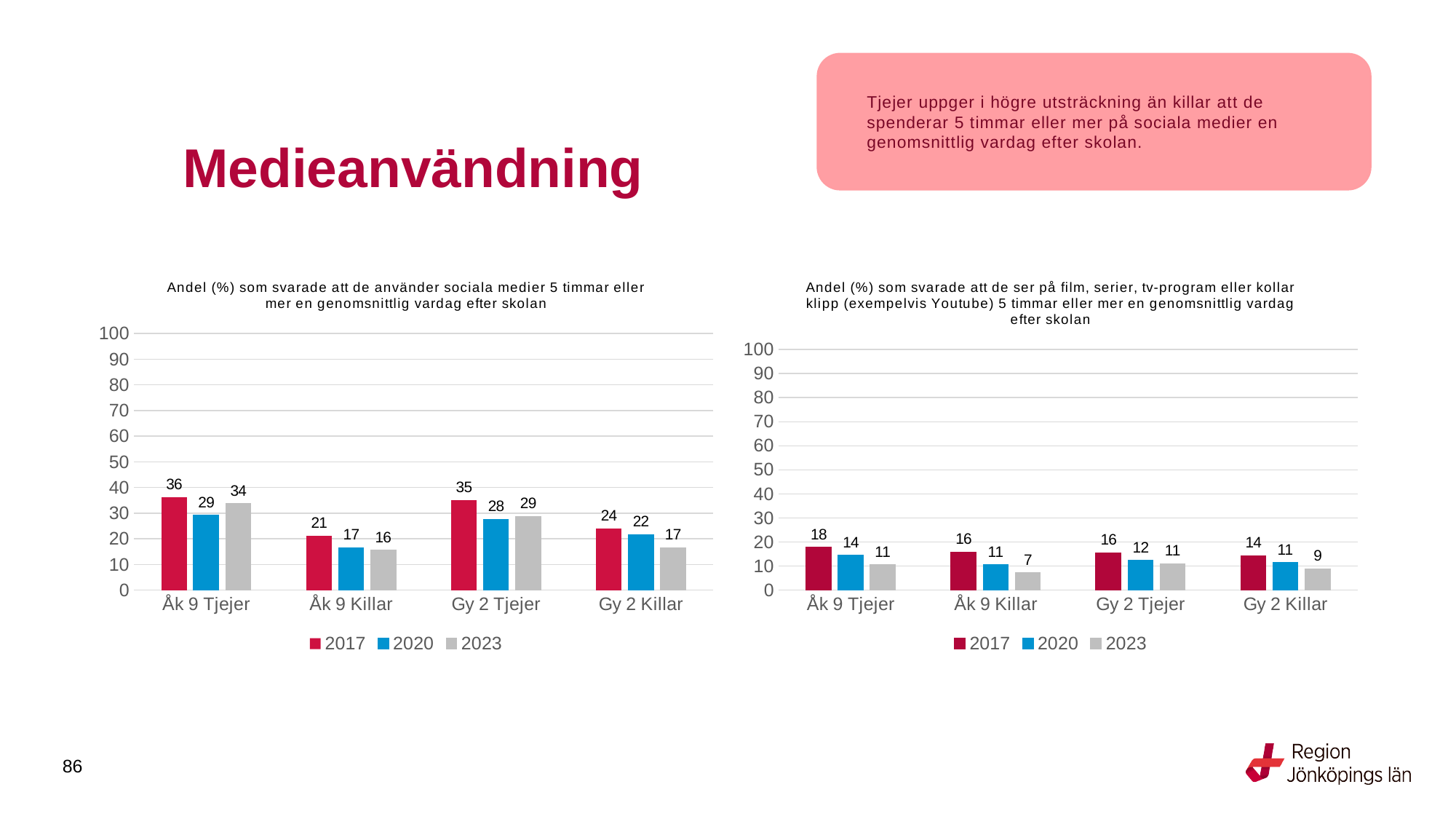
In the left chart, what is the difference between the 2017 values for Åk 9 Tjejer and Åk 9 Killar? 15 In the right chart (film, series, TV or clips 5 hours or more), what is the value for Åk 9 Killar in 2023? 7 In the right chart, do the values for Gy 2 Killar rise or fall from 2017 to 2023? Fall How many series does the legend of the right chart list? 3 In the right chart, is the 2017 value for Åk 9 Tjejer greater or less than 10? greater In the left chart (social media 5 hours or more), what is the value for Åk 9 Tjejer in 2017? 36 In the left chart, which category has the highest value for 2023? Åk 9 Tjejer In the right chart, what is the difference between the 2017 and 2023 values for Gy 2 Tjejer? 5 In the right chart, which category has the lowest value for 2023? Åk 9 Killar How many categories are shown on the x axis of the left chart? 4 What kind of chart is the left chart? Bar chart In the left chart, which is larger: the 2020 value for Gy 2 Tjejer or the 2020 value for Gy 2 Killar? Gy 2 Tjejer